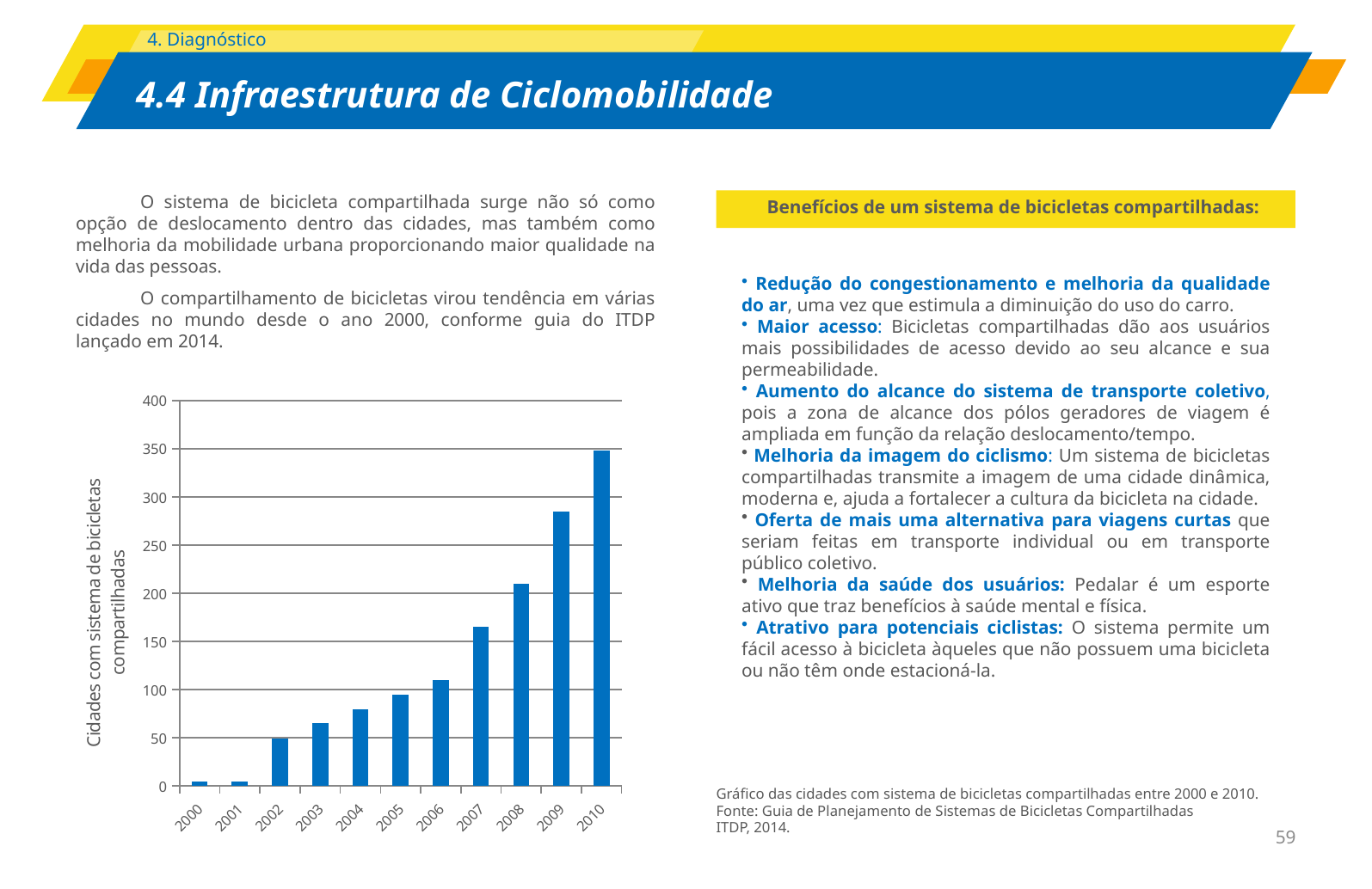
Is the value for 2007 greater or less than 200? less Is the value for 2010 greater or less than 300? greater Is the value for 2009 greater or less than 300? less What kind of chart is shown on the slide? bar chart How many years are plotted on the x axis of the chart? 11 Do the values rise or fall from 2000 to 2010? rise What is the label of the vertical axis of the chart? Cidades com sistema de bicicletas compartilhadas Which year has the highest number of cities with a bike-sharing system? 2010 Which year has the larger value, 2008 or 2009? 2009